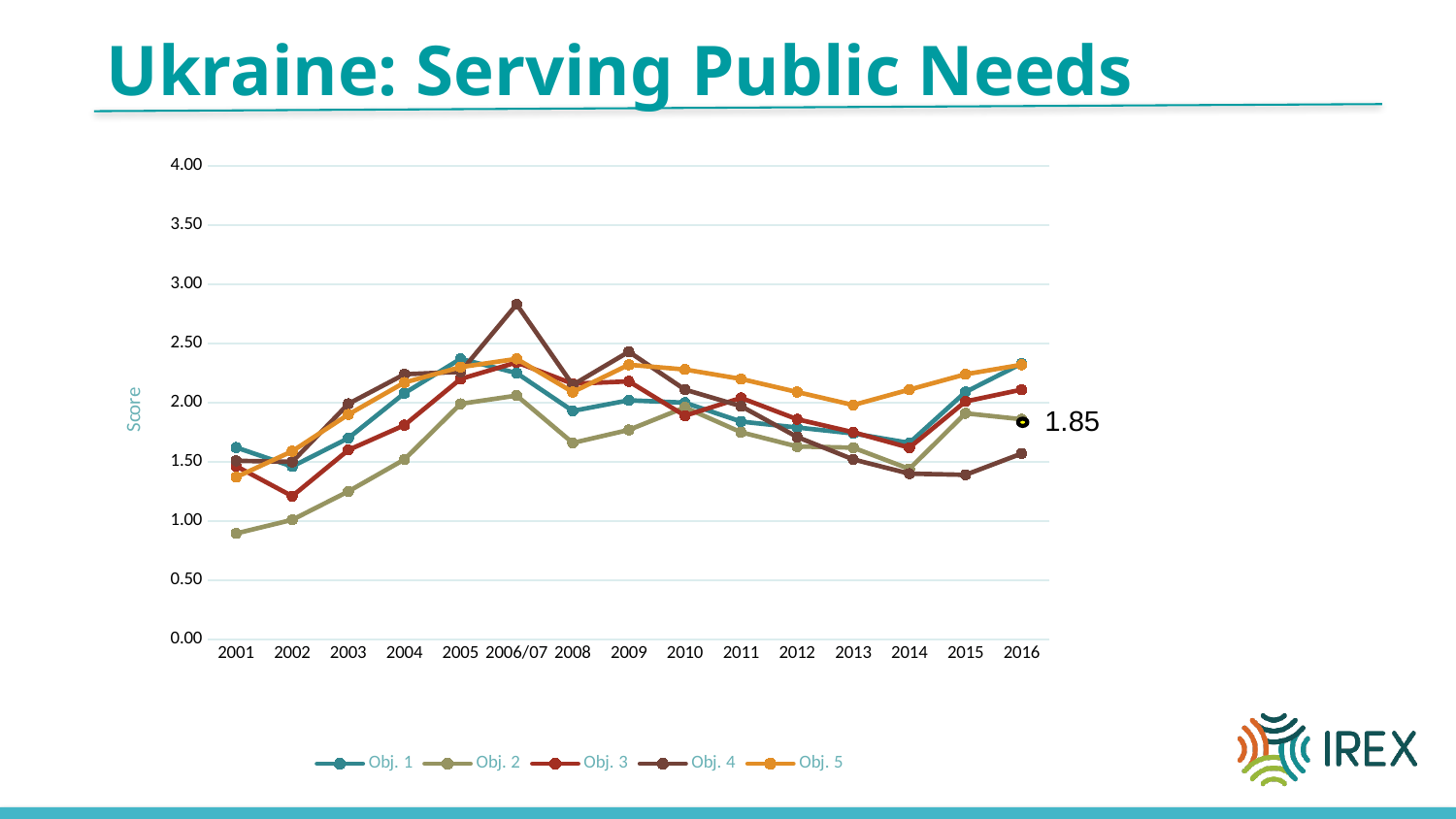
Is the value for Obj. 4 in 2006/07 greater or less than 2.50? greater How many series does the legend list? 5 Which series has the highest value in 2006/07? Obj. 4 Is the value for Obj. 2 in 2001 greater or less than 1.00? less What is the value for Obj. 2 in 2016? 1.85 Which series has the lowest value in 2016? Obj. 4 Does the value for Obj. 2 rise or fall from 2001 to 2005? rise What kind of chart is shown on the slide? Line chart What is the label on the y axis of the chart? Score How many points are on the x axis of the chart? 15 In 2016, which is larger: Obj. 2 or Obj. 4? Obj. 2 Which series has the lowest value in 2001? Obj. 2